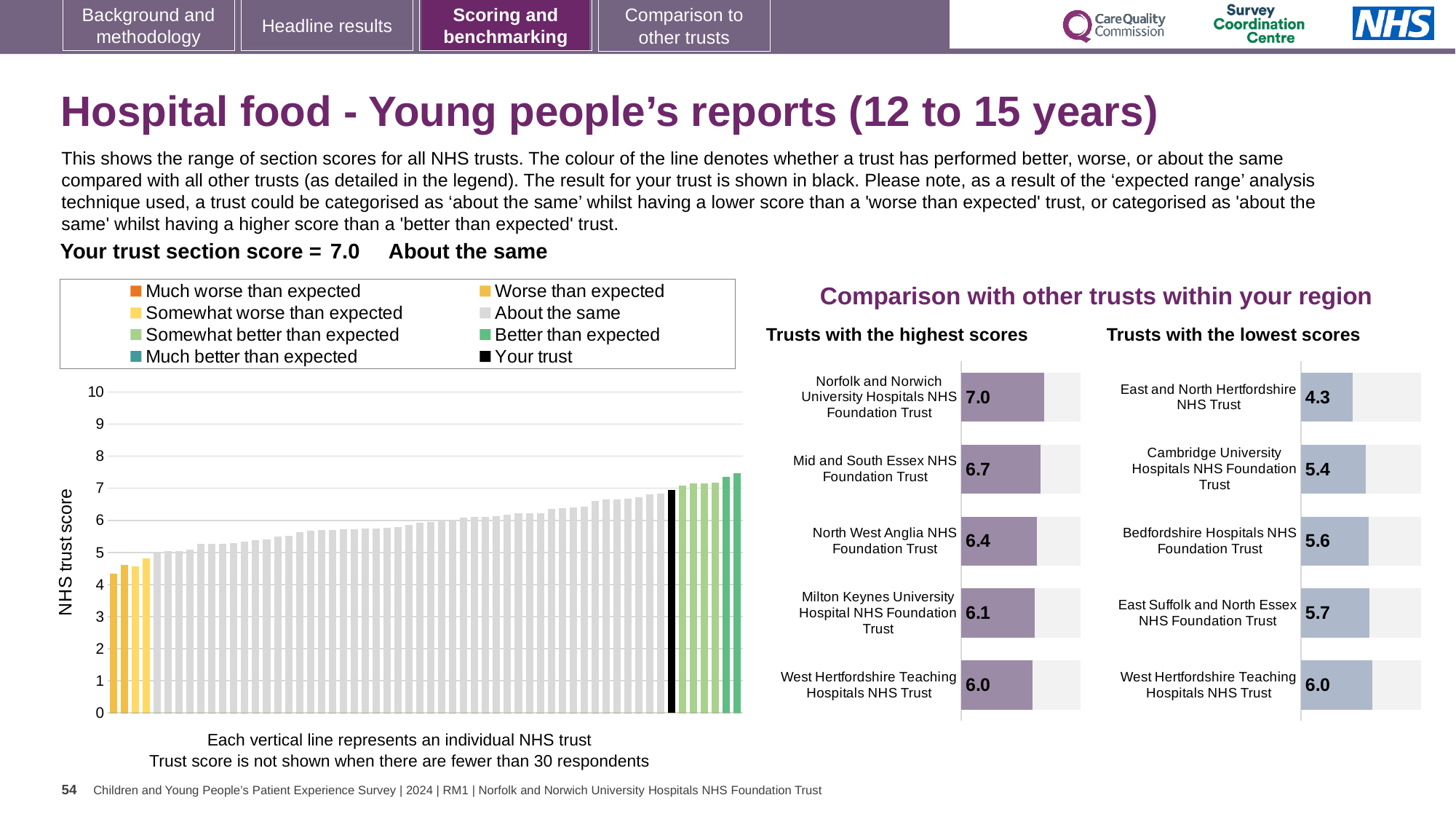
In the 'Trusts with the lowest scores' chart, what is the score for East and North Hertfordshire NHS Trust? 4.3 In the 'Trusts with the highest scores' chart, what is the score for North West Anglia NHS Foundation Trust? 6.4 How many entries does the legend of the NHS trust score chart on the left list? 8 In the 'Trusts with the highest scores' chart, which trust has the highest score? Norfolk and Norwich University Hospitals NHS Foundation Trust In the 'Trusts with the lowest scores' chart, what is the difference between the scores of West Hertfordshire Teaching Hospitals NHS Trust and East and North Hertfordshire NHS Trust? 1.7 How many trusts are shown in the 'Trusts with the highest scores' chart? 5 What kind of chart is the NHS trust score chart on the left of the slide? Bar chart In the 'Trusts with the lowest scores' chart, which has the higher score: Cambridge University Hospitals NHS Foundation Trust or Bedfordshire Hospitals NHS Foundation Trust? Bedfordshire Hospitals NHS Foundation Trust In the 'Trusts with the highest scores' chart, what is the difference between the scores of Norfolk and Norwich University Hospitals NHS Foundation Trust and Mid and South Essex NHS Foundation Trust? 0.3 In the 'Trusts with the lowest scores' chart, which trust has the lowest score? East and North Hertfordshire NHS Trust In the NHS trust score chart on the left, is the value of the lowest bar greater or less than 5? less In the 'Trusts with the highest scores' chart, what is the score for Norfolk and Norwich University Hospitals NHS Foundation Trust? 7.0